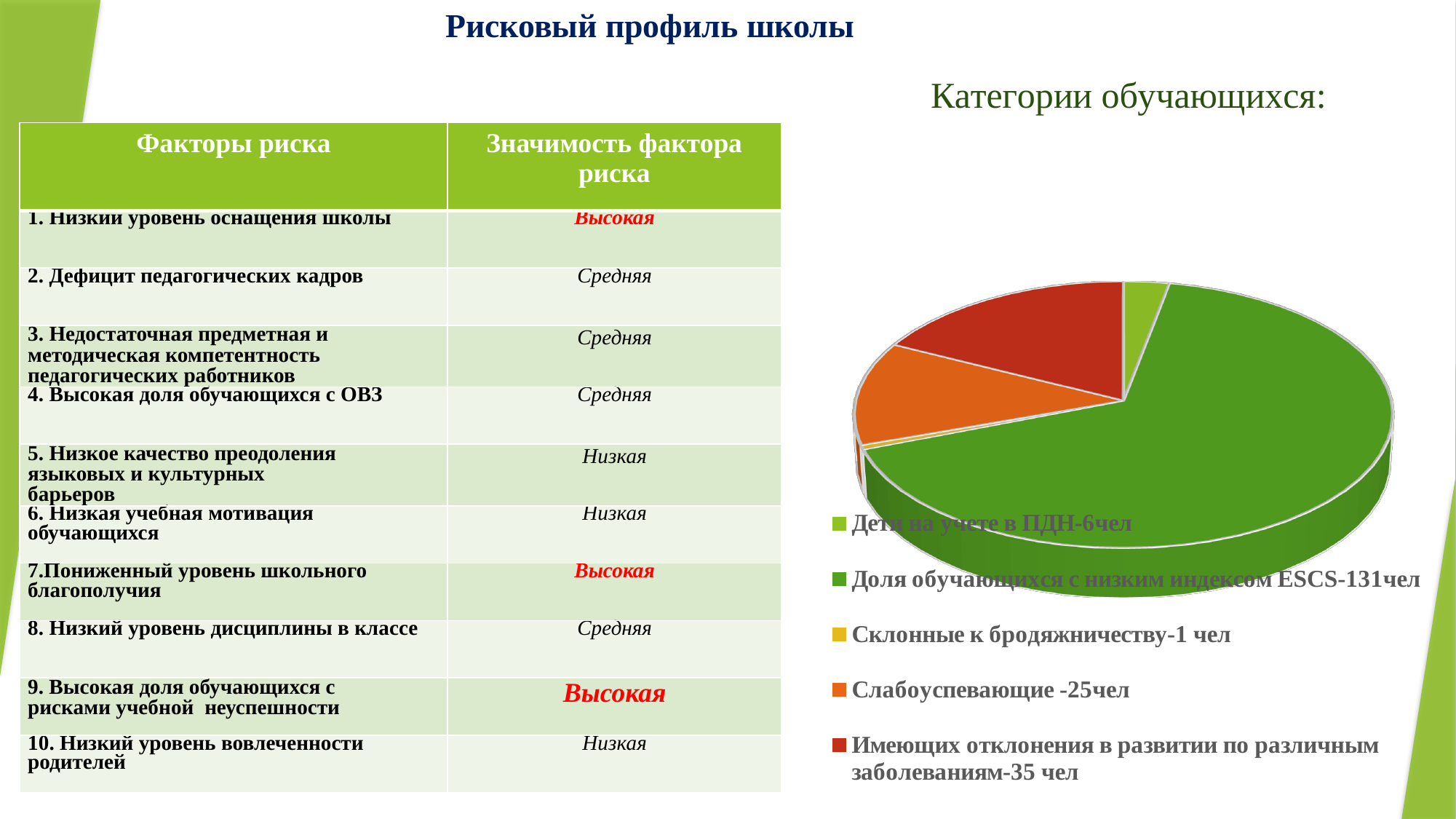
How many students are in the category 'Имеющих отклонения в развитии по различным заболеваниям'? 35 чел How many students are in the category 'Дети на учете в ПДН'? 6чел How many students are in the category 'Доля обучающихся с низким индексом ESCS'? 131чел What is the difference between the number of students 'Имеющих отклонения в развитии по различным заболеваниям' and 'Слабоуспевающие'? 10 What kind of chart is shown on the slide? pie chart What colour is the slice for 'Доля обучающихся с низким индексом ESCS'? green How many categories does the pie chart show? 5 Which category has more students: 'Слабоуспевающие' or 'Дети на учете в ПДН'? Слабоуспевающие Which category has the smallest number of students? Склонные к бродяжничеству How many students are in the category 'Слабоуспевающие'? 25чел What is the title of the chart on the slide? Категории обучающихся: Which category has the largest number of students? Доля обучающихся с низким индексом ESCS